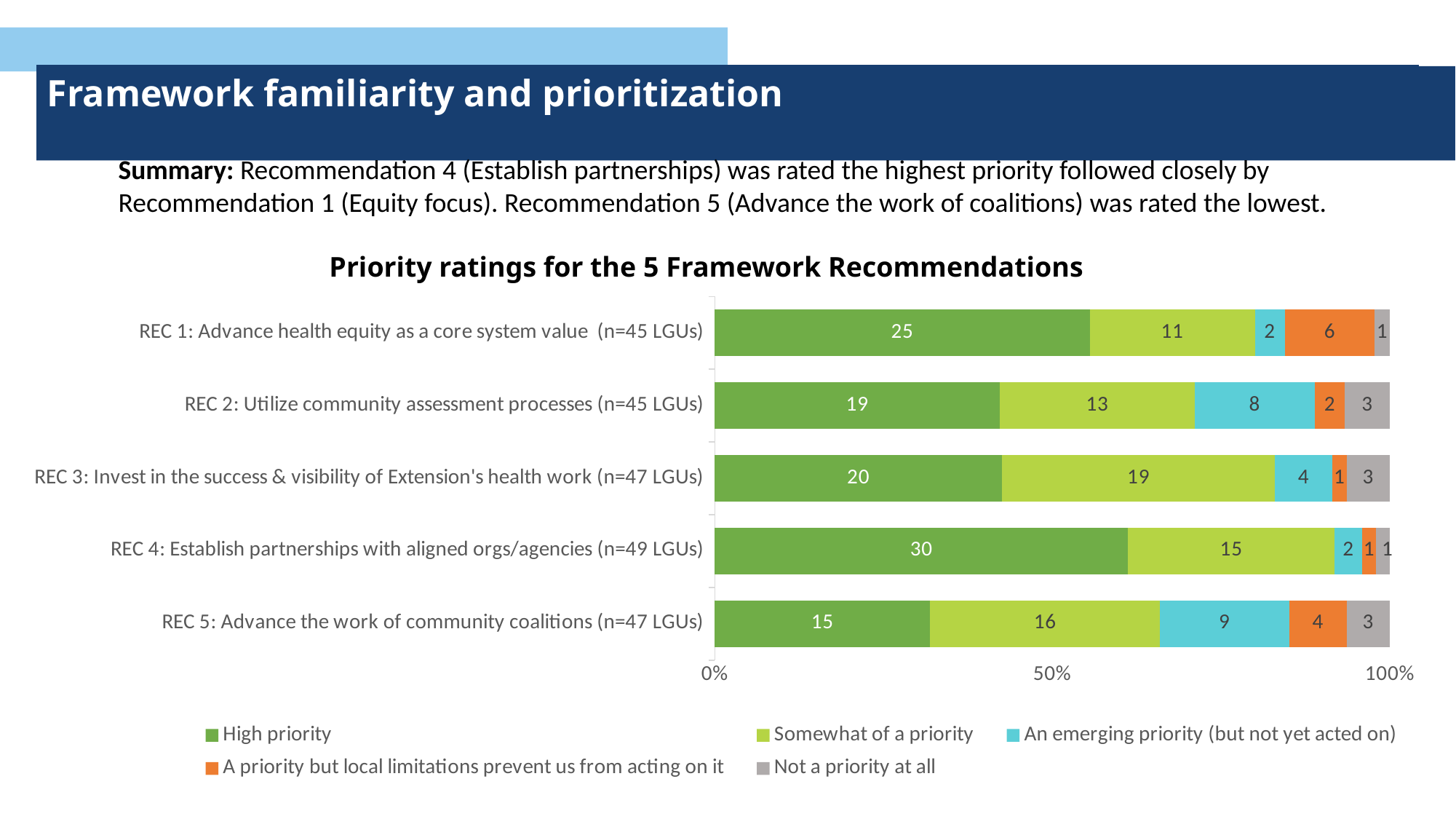
What kind of chart is shown on the slide? Stacked bar chart What is the difference between the High priority counts for REC 4 and REC 1? 5 How many recommendations (bars) are shown in the chart? 5 What is the High priority count for REC 4: Establish partnerships with aligned orgs/agencies? 30 Which has a larger 'Not a priority at all' count, REC 2 or REC 4? REC 2 How many LGUs rated REC 5: Advance the work of community coalitions as 'An emerging priority (but not yet acted on)'? 9 What is the 'Somewhat of a priority' count for REC 3: Invest in the success & visibility of Extension's health work? 19 Which recommendation has the highest High priority count? REC 4: Establish partnerships with aligned orgs/agencies How many series does the legend list? 5 Which recommendation has the lowest High priority count? REC 5: Advance the work of community coalitions What is the title of the chart? Priority ratings for the 5 Framework Recommendations What is the total of all segments in the bar for REC 2: Utilize community assessment processes? 45